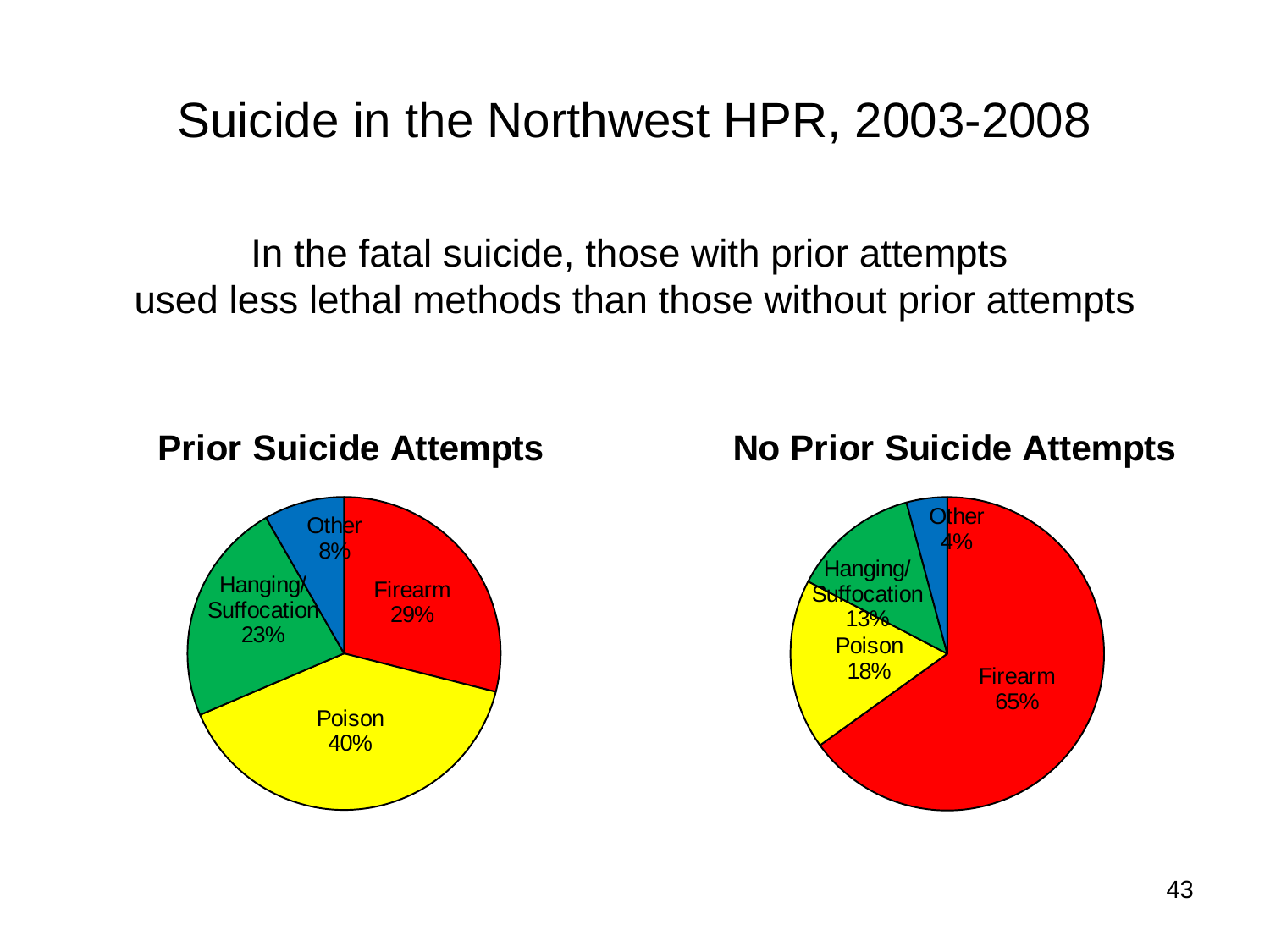
In the Prior Suicide Attempts chart, what is the difference between the Poison and Firearm shares? 11% In the Prior Suicide Attempts chart, what share of the pie is Poison? 40% In the No Prior Suicide Attempts chart, what is the value for Poison? 18% In the Prior Suicide Attempts chart, what is the value for Hanging/Suffocation? 23% In the Prior Suicide Attempts chart, which category has the largest slice? Poison Which chart has the larger Firearm share, Prior Suicide Attempts or No Prior Suicide Attempts? No Prior Suicide Attempts What kind of chart is the No Prior Suicide Attempts chart? Pie chart What colour is the Firearm slice in the Prior Suicide Attempts chart? Red In the No Prior Suicide Attempts chart, what is the difference between the Firearm and Poison shares? 47% In the No Prior Suicide Attempts chart, which category has the smallest slice? Other How many categories are shown in the Prior Suicide Attempts chart? 4 In the No Prior Suicide Attempts chart, what share of the pie is Firearm? 65%